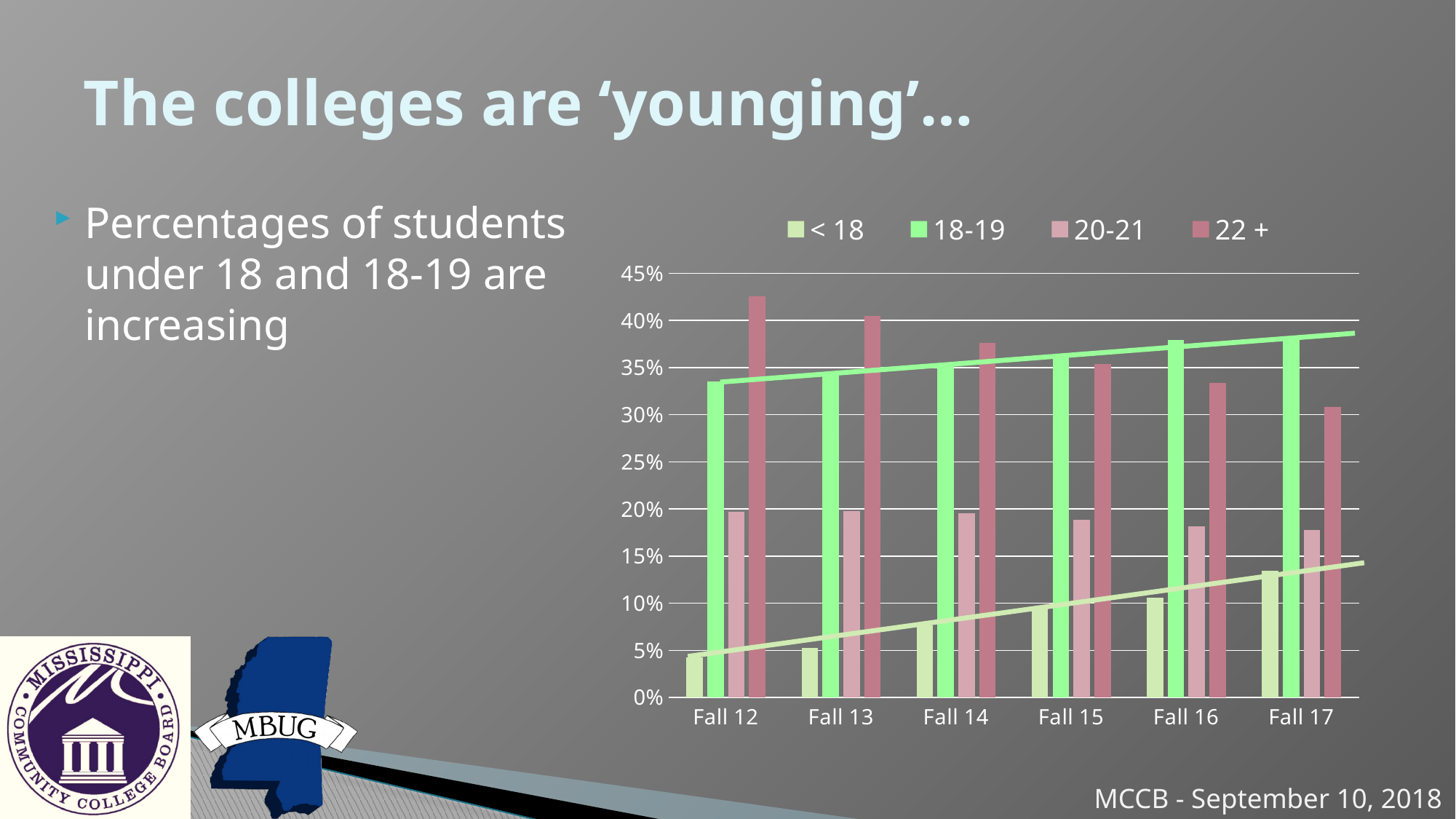
How many series does the chart legend list? 4 How many categories (semesters) are shown on the x axis of the chart? 6 Do the values for the < 18 age group rise or fall from Fall 12 to Fall 17? rise Do the values for the 22 + age group rise or fall from Fall 12 to Fall 17? fall Is the value for 18-19 in Fall 17 greater or less than 35%? greater Which is larger in Fall 17, the value for 18-19 or the value for 22 +? 18-19 What kind of chart is shown on the slide? bar chart Is the value for 22 + in Fall 12 greater or less than 40%? greater Which age group has the highest value in Fall 12? 22 + Which age group has the lowest value in Fall 14? < 18 Is the value for < 18 in Fall 17 greater or less than 15%? less Which age group has the highest value in Fall 17? 18-19